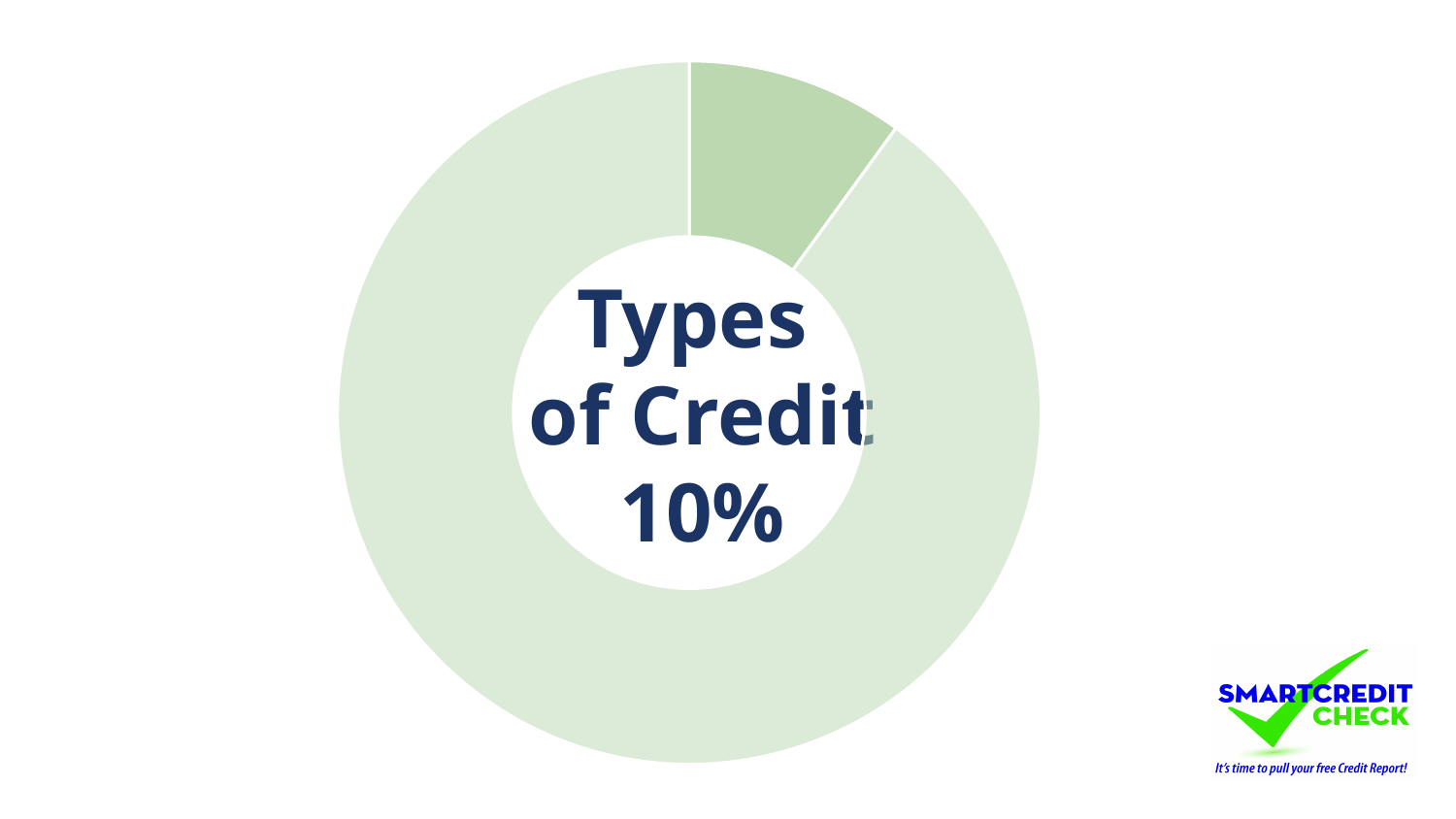
What kind of chart is shown on the slide? doughnut chart How many slices does the doughnut chart have? 2 Is the highlighted Types of Credit slice a darker or lighter green than the rest of the doughnut? darker What share of the doughnut chart does the Types of Credit slice represent? 10% Which is larger: the highlighted Types of Credit slice or the remaining portion of the doughnut? the remaining portion What percentage is shown for Types of Credit? 10% What text is displayed in the centre of the doughnut chart? Types of Credit 10% Is the Types of Credit slice greater or less than 25% of the chart? less